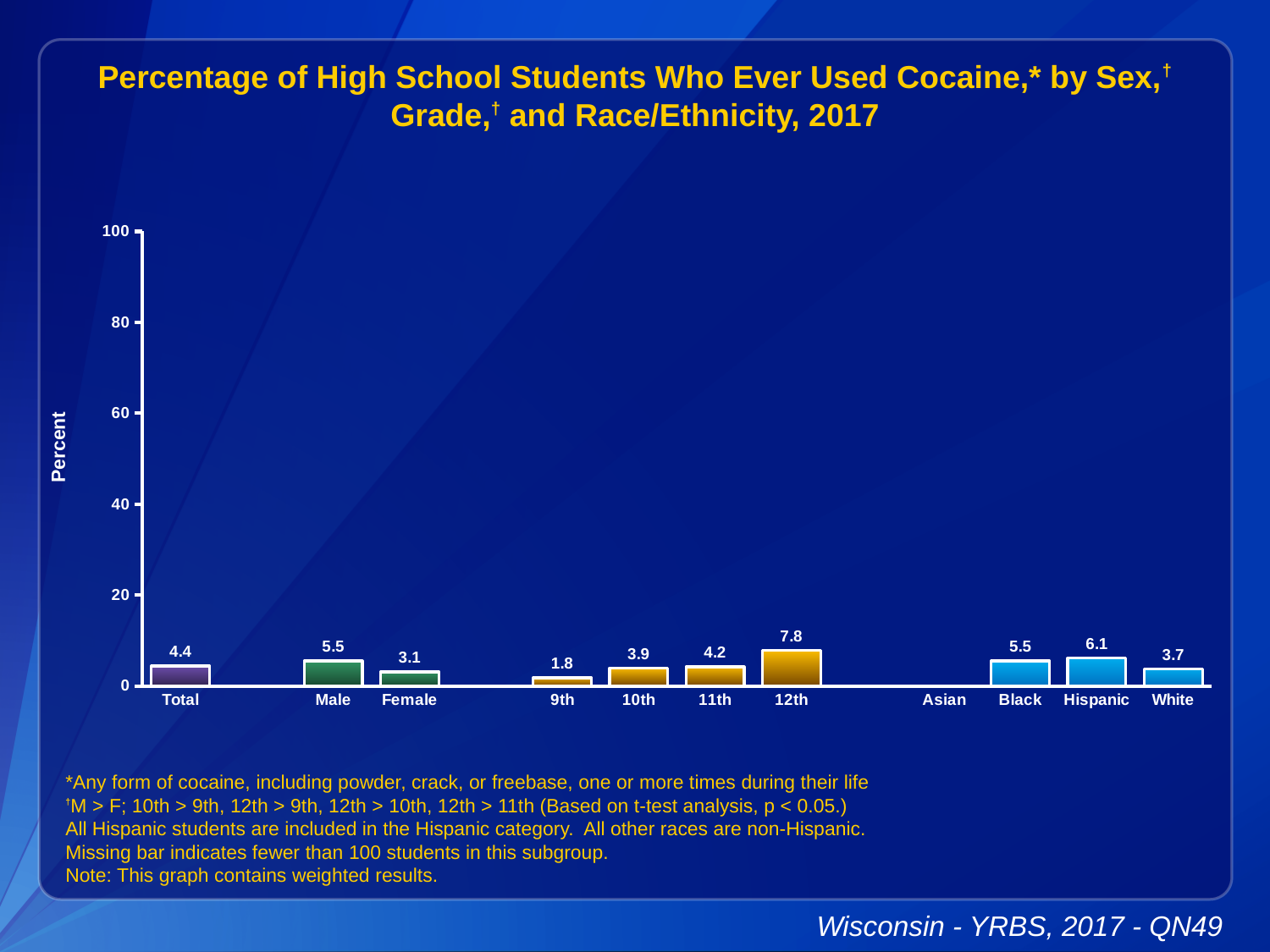
Which category has the lowest plotted value on the chart? 9th What is the difference between the values for Male and Female students? 2.4 What percentage of students in the Total category ever used cocaine? 4.4 Which category on the x axis has no bar plotted? Asian How many bars are plotted on the chart? 10 What is the value shown for Hispanic students? 6.1 What kind of chart is shown on the slide? bar chart Is the value for 12th grade students greater or less than 20? less What is the difference between the values for 12th grade and 9th grade students? 6.0 What is the value shown for 12th grade students? 7.8 Which is larger, the value for Black students or the value for White students? Black Which category has the highest value on the chart? 12th